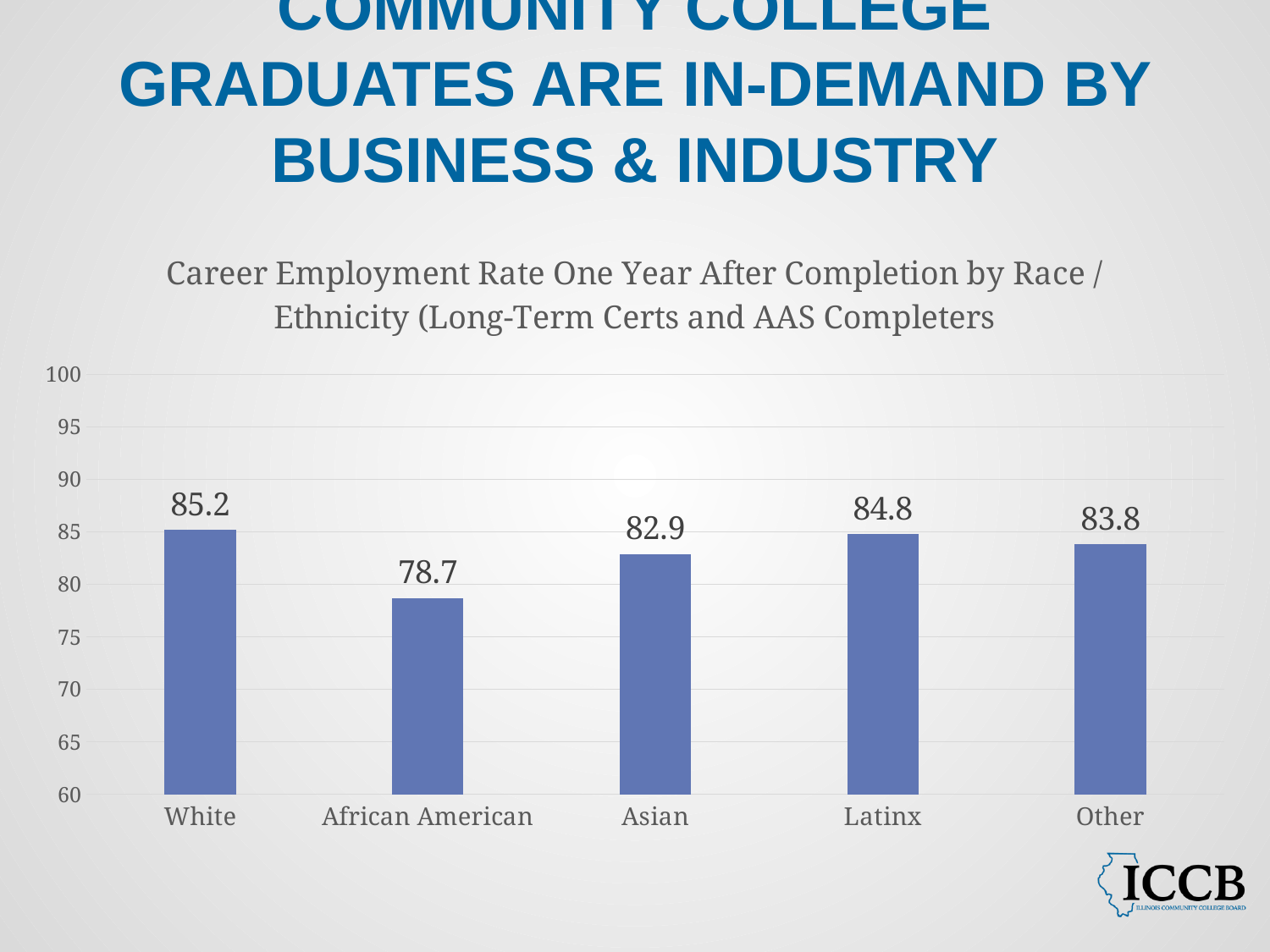
Which has a higher career employment rate, Asian or Other? Other Which race/ethnicity group has the highest career employment rate? White Is the value for African American completers greater or less than 80? less What is the career employment rate for African American completers? 78.7 What is the career employment rate for Latinx completers? 84.8 What is the difference between the career employment rates for Latinx and Asian completers? 1.9 What is the difference between the career employment rates for White and African American completers? 6.5 What is the career employment rate for Asian completers? 82.9 Which race/ethnicity group has the lowest career employment rate? African American What is the career employment rate for White completers? 85.2 What kind of chart is shown on the slide? Bar chart How many race/ethnicity categories are shown in the chart? 5